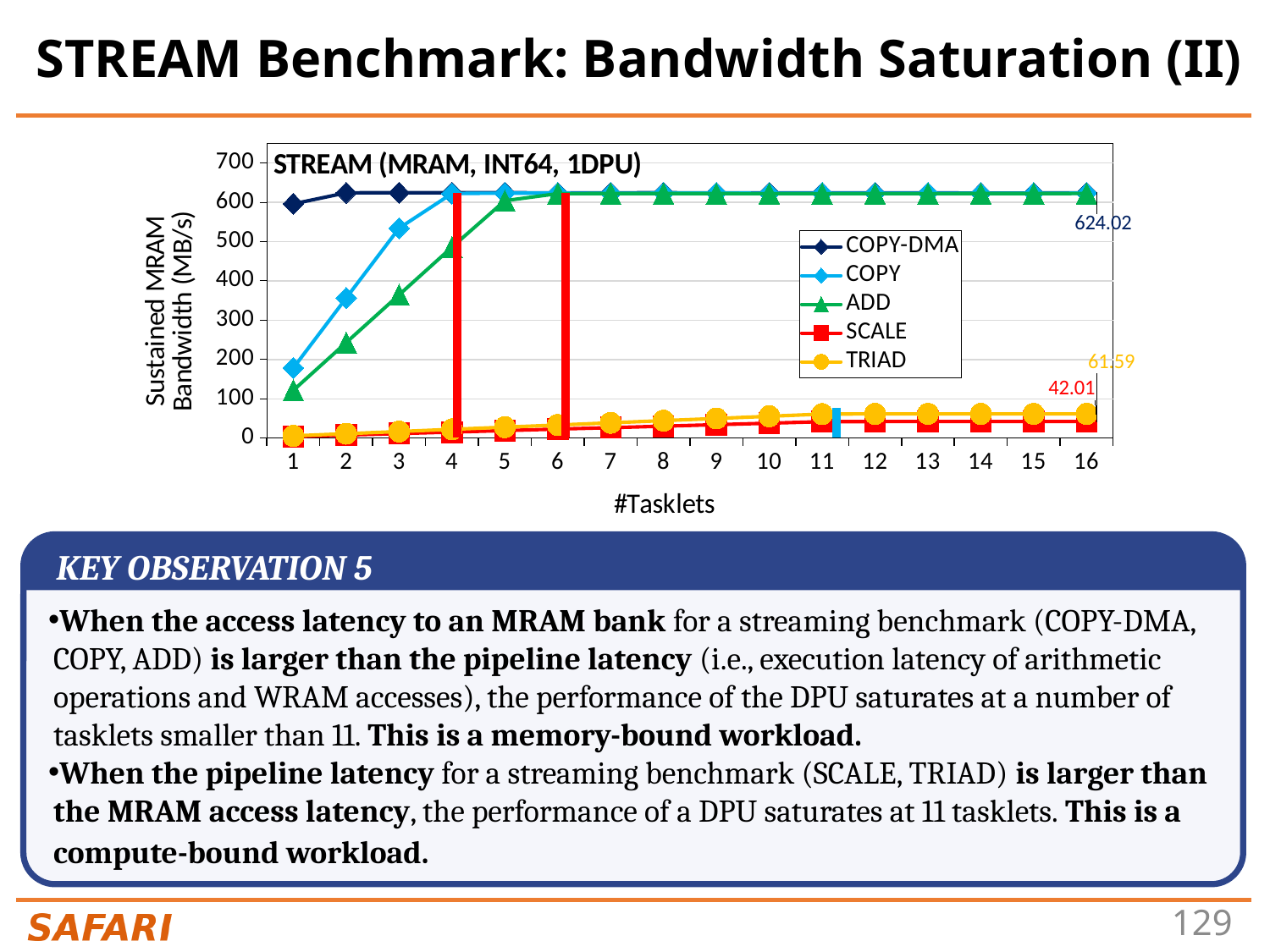
Which series has the highest bandwidth at 1 tasklet? COPY-DMA Is the COPY-DMA value at 1 tasklet greater or less than 500? greater What kind of chart is shown on the slide? line chart What is the labelled sustained MRAM bandwidth for COPY-DMA at 16 tasklets? 624.02 At 16 tasklets, which has the higher bandwidth, TRIAD or SCALE? TRIAD Does the COPY bandwidth rise or fall as the number of tasklets increases from 1 to 4? rise What is the labelled sustained MRAM bandwidth for TRIAD at 16 tasklets? 61.59 How many #Tasklets values are plotted along the x axis? 16 What is the labelled sustained MRAM bandwidth for SCALE at 16 tasklets? 42.01 What is the title shown inside the chart area? STREAM (MRAM, INT64, 1DPU) What is the difference between the labelled TRIAD and SCALE values at 16 tasklets? 19.58 How many series does the chart legend list? 5